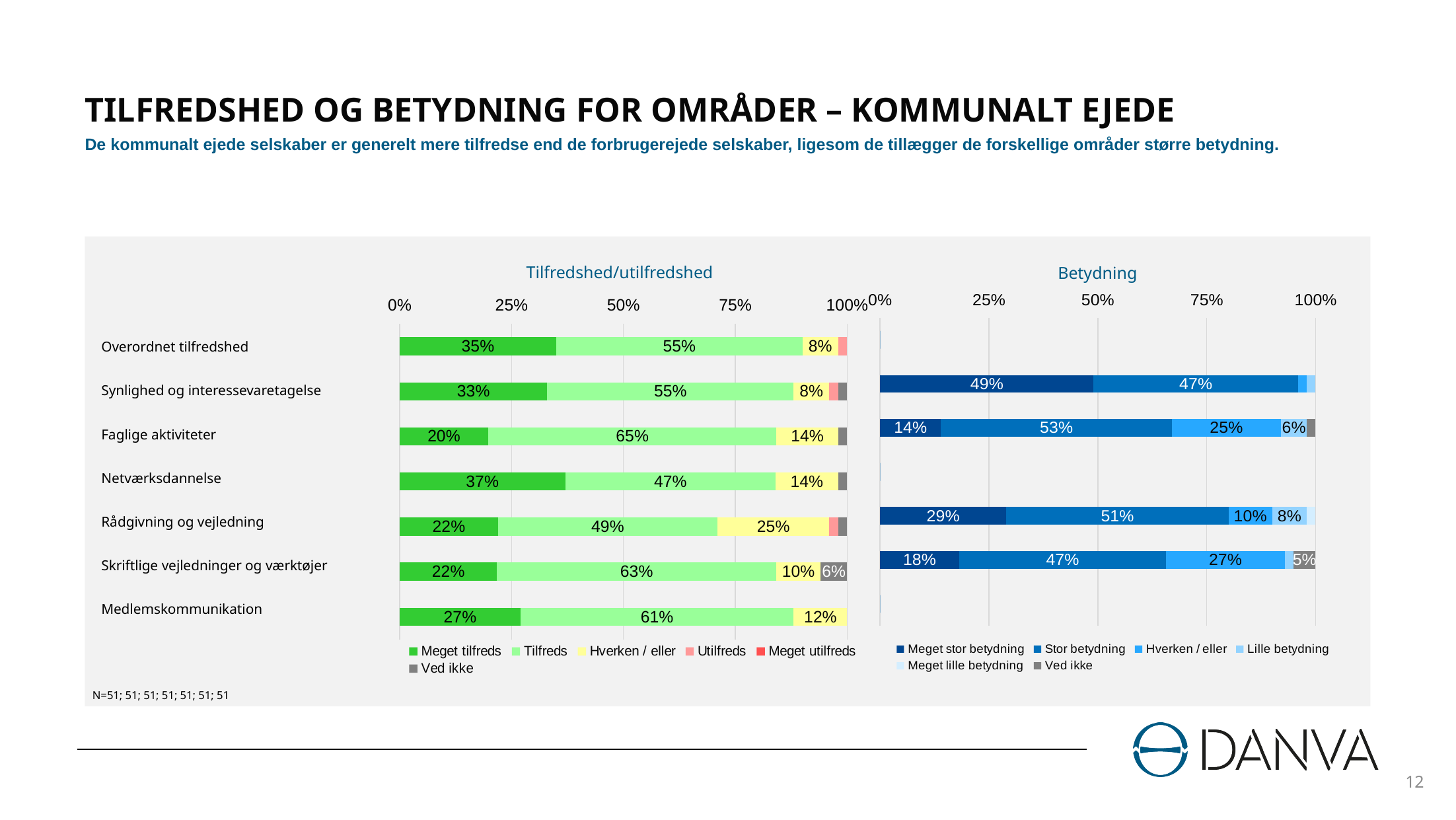
In the Tilfredshed/utilfredshed chart, which has the larger Tilfreds value: Medlemskommunikation or Skriftlige vejledninger og værktøjer? Skriftlige vejledninger og værktøjer In the Betydning chart, what is the Hverken / eller value for Skriftlige vejledninger og værktøjer? 27% In the Tilfredshed/utilfredshed chart, what is the difference between the Hverken / eller values for Rådgivning og vejledning and Overordnet tilfredshed? 17 percentage points In the Tilfredshed/utilfredshed chart, which category has the highest Meget tilfreds value? Netværksdannelse How many categories are shown in the Tilfredshed/utilfredshed chart? 7 In the Betydning chart, which category has the highest Meget stor betydning value? Synlighed og interessevaretagelse What kind of chart is the Betydning chart? Stacked bar chart In the Tilfredshed/utilfredshed chart, which category has the lowest Meget tilfreds value? Faglige aktiviteter In the Betydning chart, what is the Stor betydning value for Faglige aktiviteter? 53% In the Tilfredshed/utilfredshed chart, what is the Meget tilfreds value for Netværksdannelse? 37% In the Tilfredshed/utilfredshed chart, what is the Tilfreds value for Faglige aktiviteter? 65% How many series does the legend of the Tilfredshed/utilfredshed chart list? 6